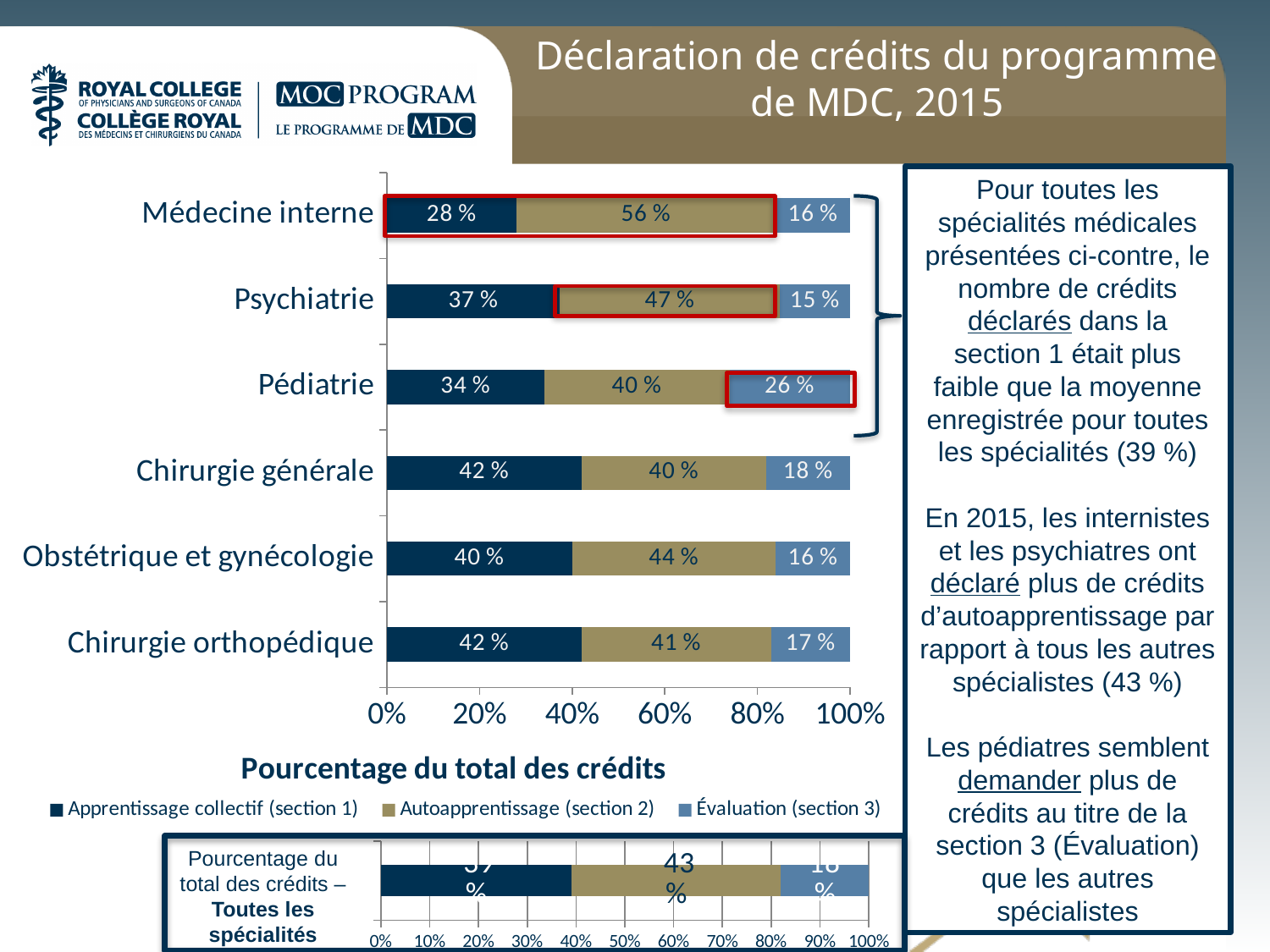
What type of chart is the main chart on the slide? Stacked bar chart How many specialties are shown in the main chart? 6 In the main chart, which specialty has the highest Autoapprentissage (section 2) percentage? Médecine interne How many series does the legend of the main chart list? 3 What is the total of the three segments for Médecine interne in the main chart? 100 % In the main chart, what percentage of credits did Médecine interne declare under Autoapprentissage (section 2)? 56 % In the main chart, what is the Évaluation (section 3) value for Pédiatrie? 26 % In the main chart, what is the difference between the section 1 values for Chirurgie générale and Médecine interne? 14 % In the main chart, what is the Apprentissage collectif (section 1) value for Psychiatrie? 37 % In the main chart, which is larger: the section 2 value for Psychiatrie or for Obstétrique et gynécologie? Psychiatrie In the main chart, which specialty has the highest Évaluation (section 3) percentage? Pédiatrie In the main chart, which specialty has the lowest Apprentissage collectif (section 1) percentage? Médecine interne